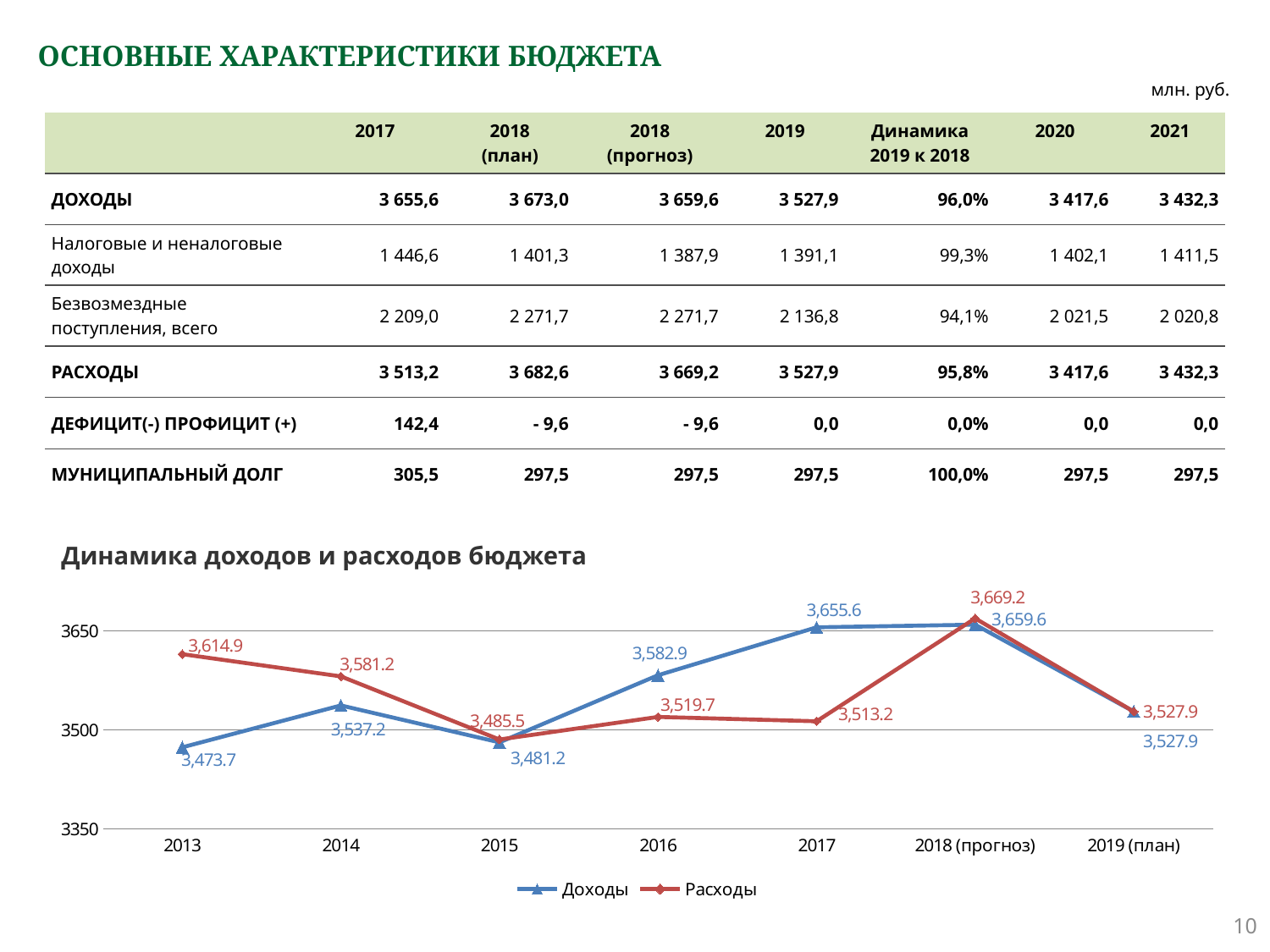
How many years are plotted along the x axis of the chart "Динамика доходов и расходов бюджета"? 7 In the chart "Динамика доходов и расходов бюджета", in which year is Доходы lowest? 2013 In the chart "Динамика доходов и расходов бюджета", is the value of Расходы for 2013 greater or less than 3500? greater In the chart "Динамика доходов и расходов бюджета", which is larger in 2014, Доходы or Расходы? Расходы In the chart "Динамика доходов и расходов бюджета", what is the difference between Доходы and Расходы in 2017? 142.4 How many series does the legend of the chart "Динамика доходов и расходов бюджета" list? 2 In the chart "Динамика доходов и расходов бюджета", what is the value of Доходы for 2013? 3,473.7 In the chart "Динамика доходов и расходов бюджета", in which year is Расходы highest? 2018 (прогноз) What kind of chart is "Динамика доходов и расходов бюджета"? line chart In the chart "Динамика доходов и расходов бюджета", what is the value of Расходы for 2016? 3,519.7 In the chart "Динамика доходов и расходов бюджета", what is the difference between Расходы and Доходы in 2013? 141.2 In the chart "Динамика доходов и расходов бюджета", does Расходы rise or fall from 2013 to 2015? fall